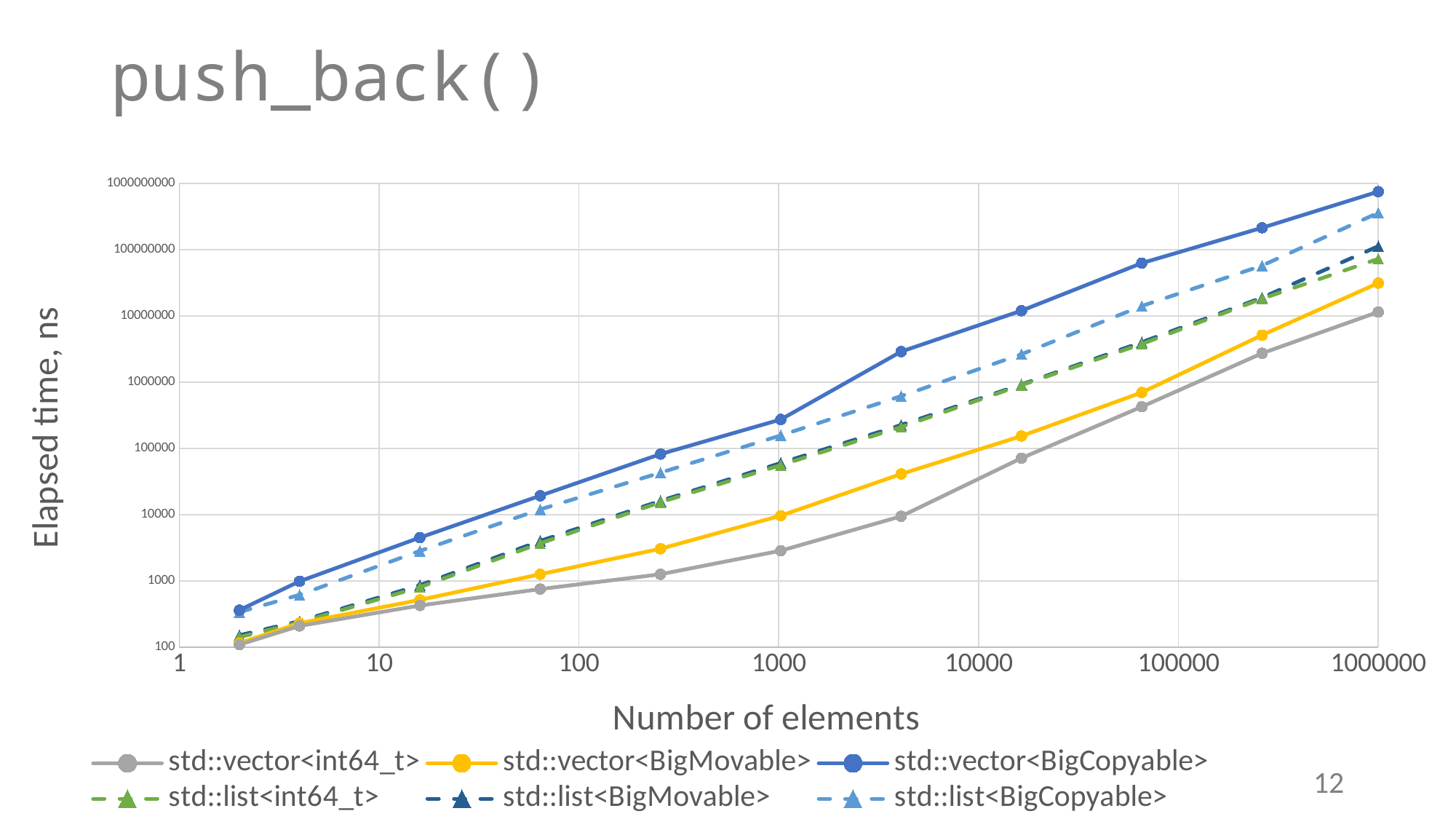
Which series has the lowest elapsed time at 1000000 elements? std::vector<int64_t> What is the title of the chart? push_back() What kind of chart is shown on the slide? line chart How many series does the legend list? 6 Is the elapsed time for std::vector<BigMovable> at 1000000 elements greater or less than 100000000 ns? less How many data points are plotted for the std::vector<BigCopyable> series? 11 Which series has the highest elapsed time at 1000000 elements? std::vector<BigCopyable> Is the elapsed time for std::vector<BigCopyable> at 1000 elements greater or less than 100000 ns? greater What is the label of the y axis? Elapsed time, ns At 1000000 elements, which is larger: the elapsed time for std::list<BigCopyable> or for std::vector<BigMovable>? std::list<BigCopyable> Is the elapsed time for std::vector<BigCopyable> at 1000000 elements greater or less than 100000000 ns? greater Does the elapsed time for std::vector<int64_t> rise or fall as the number of elements increases? rise